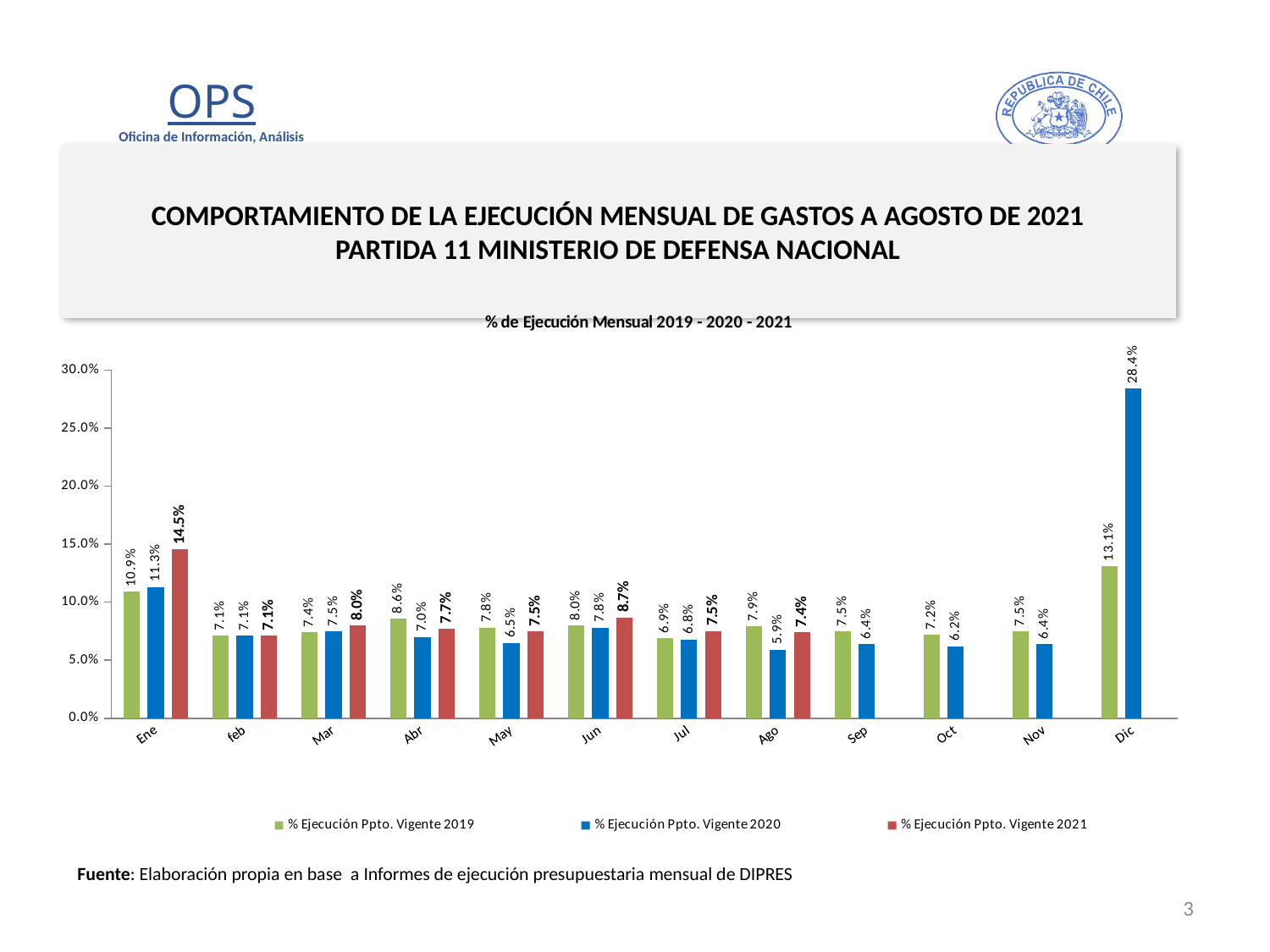
What is the value of % Ejecución Ppto. Vigente 2021 for Ene? 14.5% What is the difference between the 2020 and 2019 values for Dic? 15.3 percentage points Is the 2020 value for Dic greater or less than 25.0%? greater What is the value of % Ejecución Ppto. Vigente 2020 for Dic? 28.4% For Abr, which series has the larger value: 2019 or 2020? % Ejecución Ppto. Vigente 2019 In which month is the % Ejecución Ppto. Vigente 2020 series lowest? Ago What is the value of % Ejecución Ppto. Vigente 2019 for Ago? 7.9% How many months are shown on the x axis? 12 What kind of chart is shown on the slide? Bar chart How many series does the legend list? 3 In which month is the % Ejecución Ppto. Vigente 2020 series highest? Dic What is the difference between the 2021 and 2019 values for Ene? 3.6 percentage points